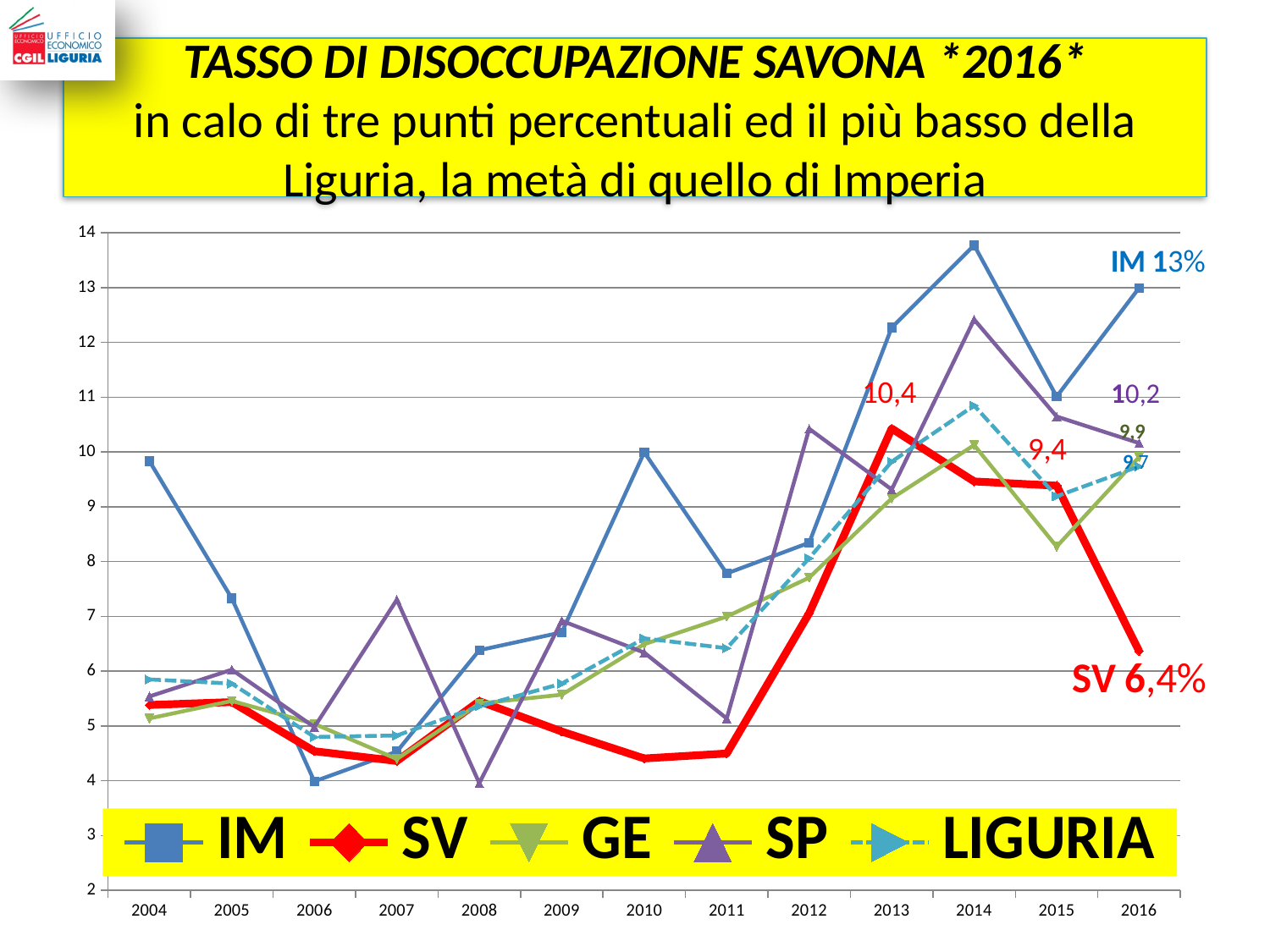
What is the difference between the IM and SV values in 2016? 6,6 What is the value for SV in 2013? 10,4 What is the value for GE in 2016? 9,9 Is the value for IM in 2014 greater or less than 13? greater What is the value for SV in 2016? 6,4% What kind of chart is shown on the slide? line chart What is the value for SV in 2015? 9,4 What is the value for SP in 2016? 10,2 Which series has the highest value in 2016? IM What is the value for IM in 2016? 13% How many years are plotted along the x axis? 13 How many series does the legend list? 5